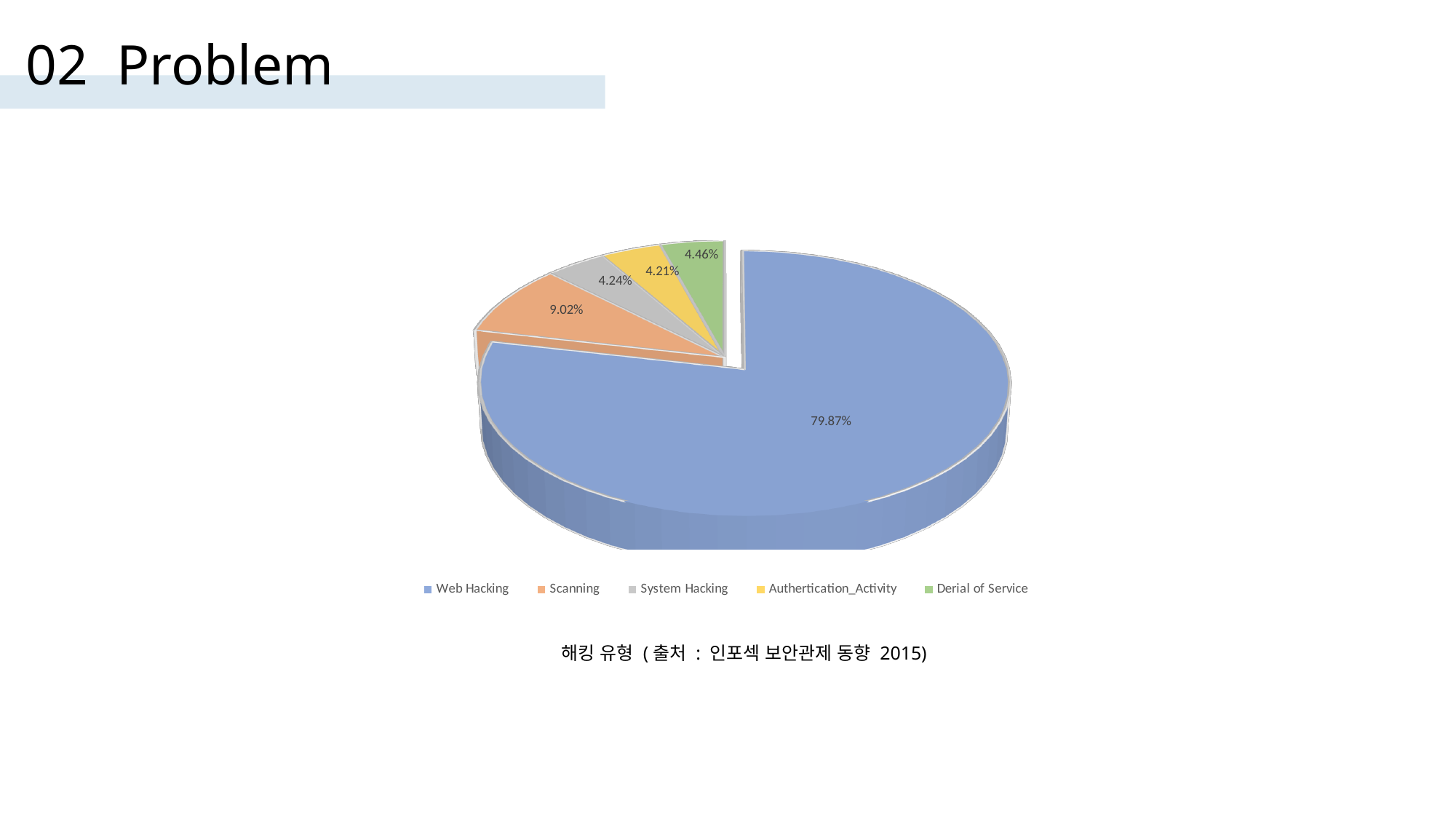
Which category has the smallest share of the pie? Authertication_Activity How many slices does the pie chart have? 5 What type of chart is shown on the slide? Pie chart Which category has the largest share of the pie? Web Hacking What percentage does the Web Hacking slice show? 79.87% What percentage does the Derial of Service slice show? 4.46% What is the difference between the Web Hacking and Scanning percentages? 70.85% What percentage does the System Hacking slice show? 4.24% Which is larger, the Scanning slice or the Derial of Service slice? Scanning What colour is the Web Hacking slice? Blue What percentage does the Scanning slice show? 9.02% What percentage does the Authertication_Activity slice show? 4.21%